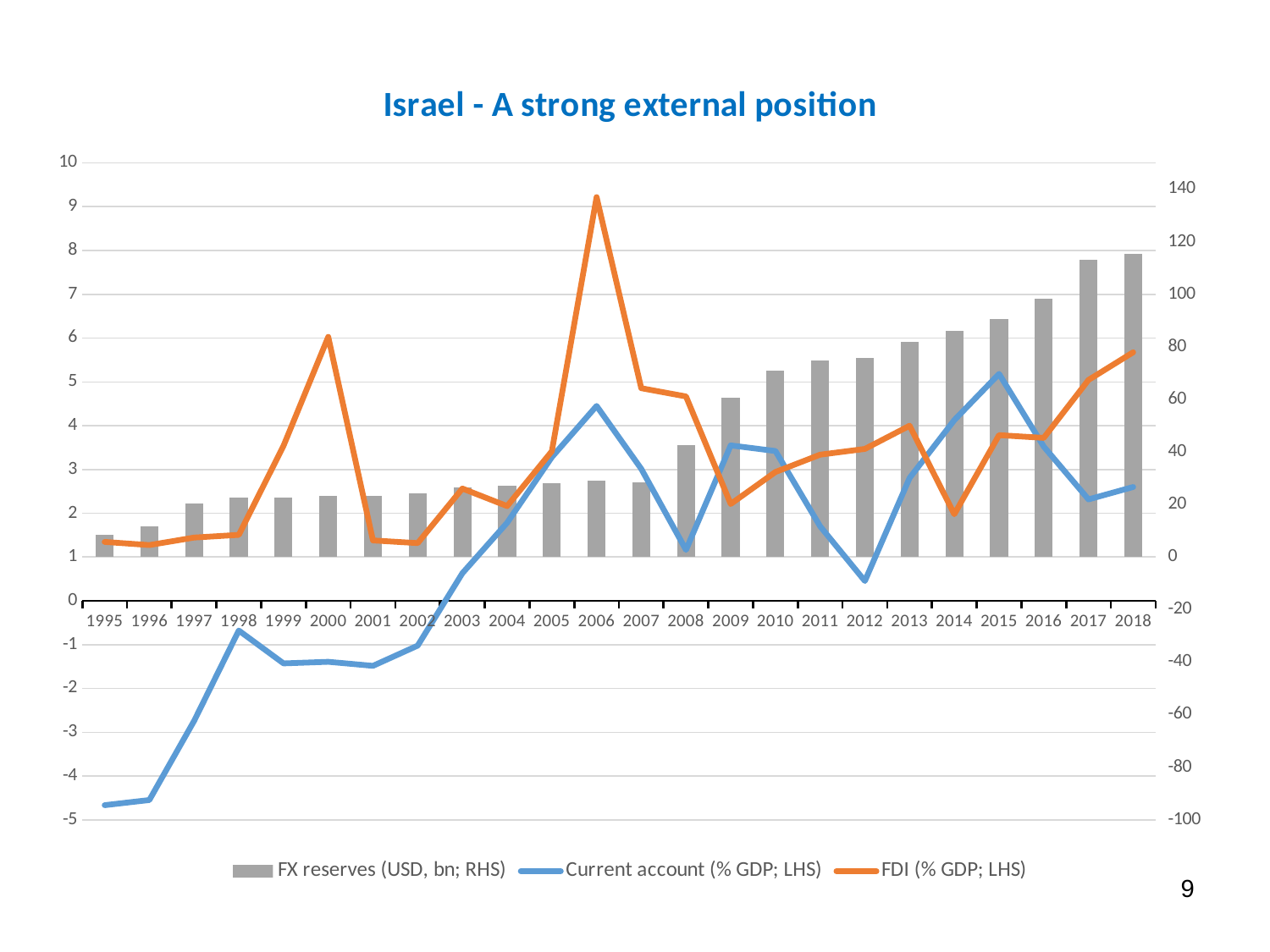
What kind of chart is this? Combined bar and line chart Which year has higher FX reserves (USD, bn; RHS), 2005 or 2010? 2010 In which year are FX reserves (USD, bn; RHS) lowest? 1995 In which year does FDI (% GDP; LHS) reach its peak? 2006 In which year are FX reserves (USD, bn; RHS) highest? 2018 How many series does the legend list? 3 In which year is the Current account (% GDP; LHS) highest? 2015 What is the title of the chart? Israel - A strong external position Is the value of FDI (% GDP; LHS) in 2006 greater or less than 8? greater How many years are shown on the x axis? 24 Is the Current account (% GDP; LHS) in 1995 greater or less than -4? less Is the value of FX reserves (USD, bn; RHS) in 2018 greater or less than 100? greater